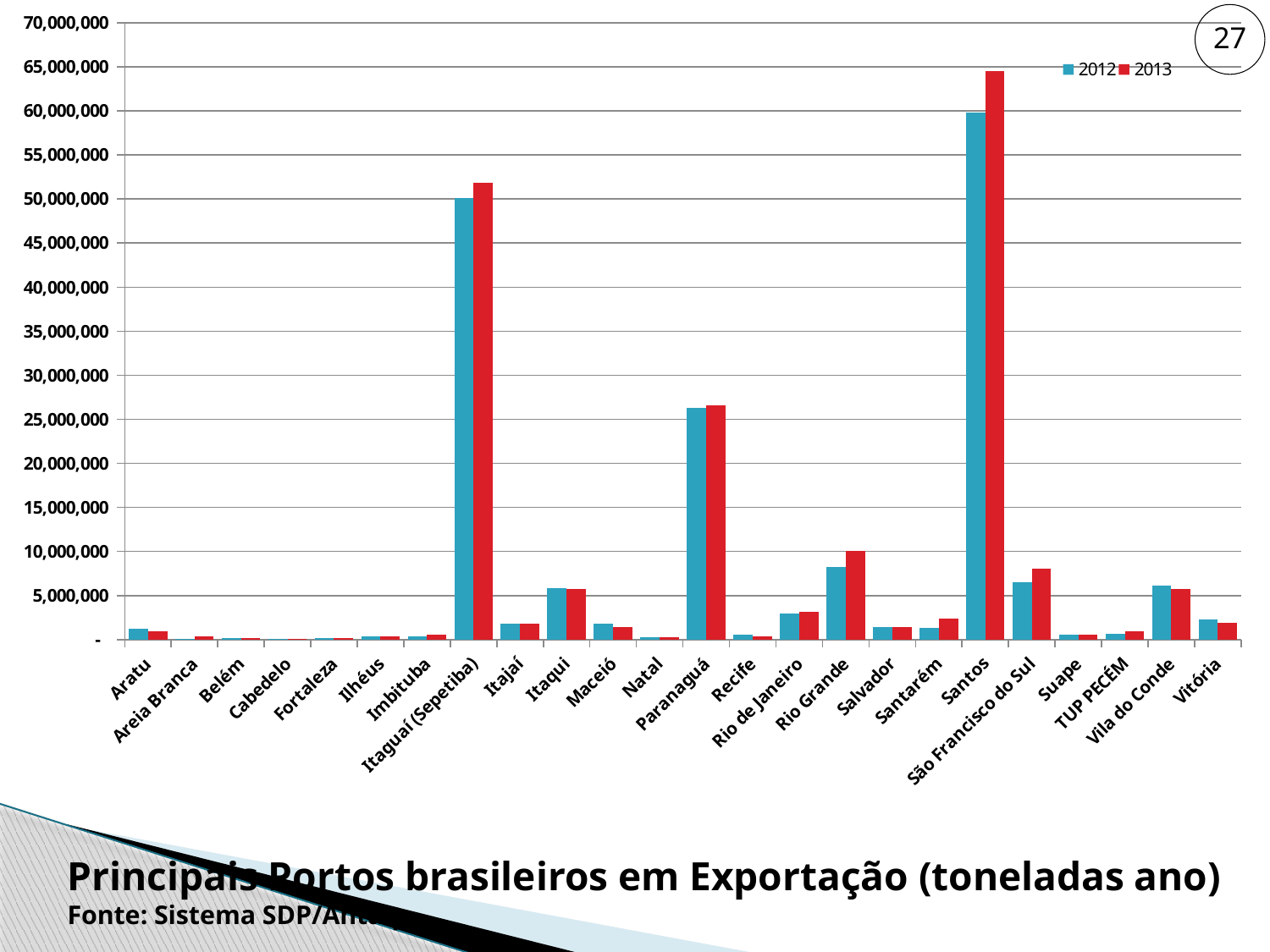
What kind of chart is shown on the slide? bar chart Is the 2012 value for Paranaguá greater or less than 25,000,000? greater Which port has the highest value for 2012? Santos How many series does the legend list? 2 Is the 2013 value for Santos greater or less than 60,000,000? greater For Santos, which year has the larger value, 2012 or 2013? 2013 Which port has the highest value for 2013? Santos How many ports (categories) are shown on the x axis? 24 Is the 2012 value for Rio Grande greater or less than 5,000,000? greater For Santarém, which year has the larger value, 2012 or 2013? 2013 Which colour represents the 2013 series in the legend? red